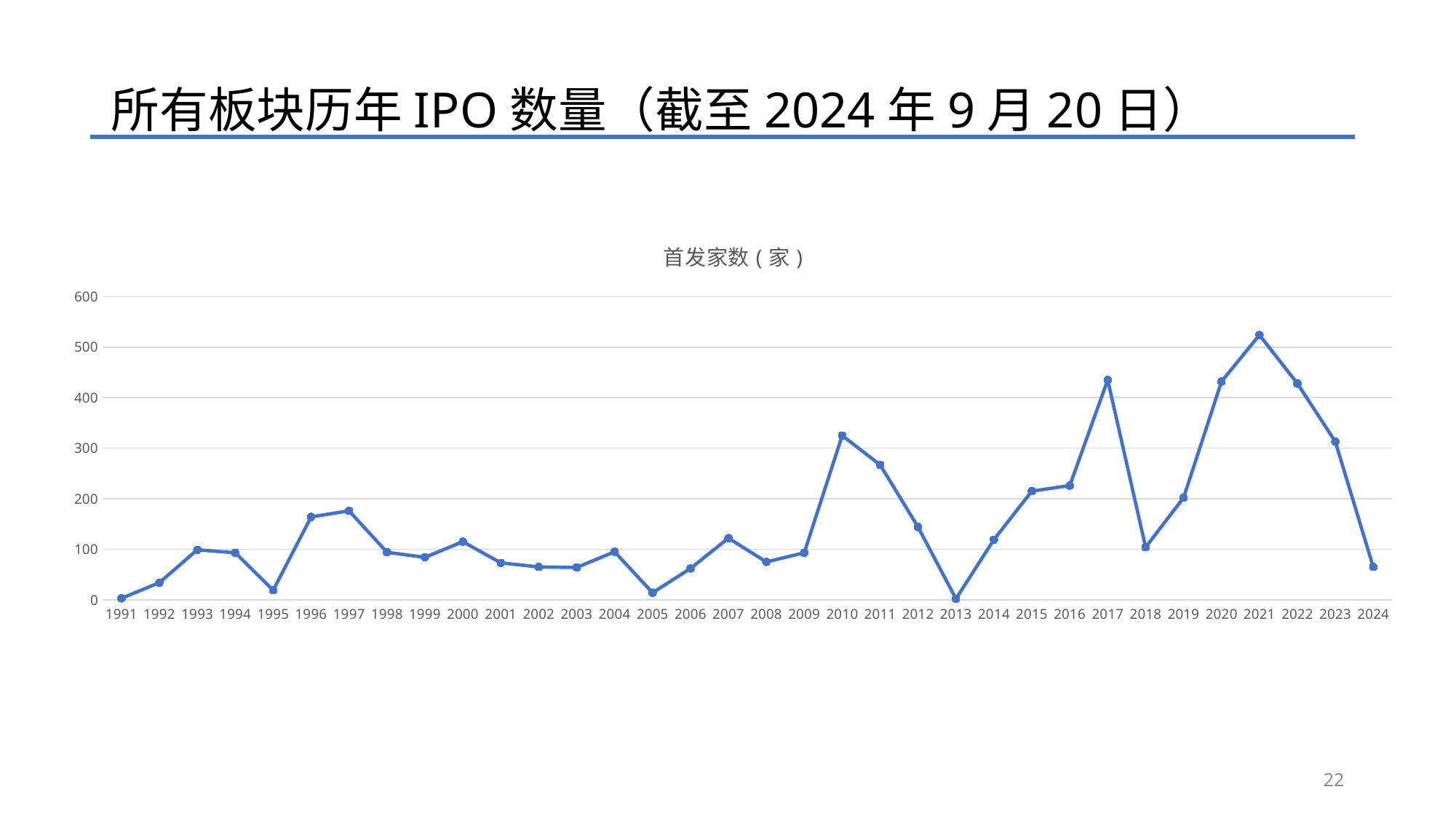
How many years are plotted along the x axis? 34 Which year has the highest number of IPOs (首发家数)? 2021 Which year has the larger value, 2017 or 2010? 2017 What is the title shown above the chart? 首发家数（家） Is the value for 2024 greater or less than 100? less Is the value for 2021 greater or less than 500? greater Is the value for 2017 greater or less than 400? greater What kind of chart is shown on the slide? line chart Do the values rise or fall from 2021 to 2024? fall Which year has the larger value, 2015 or 2014? 2015